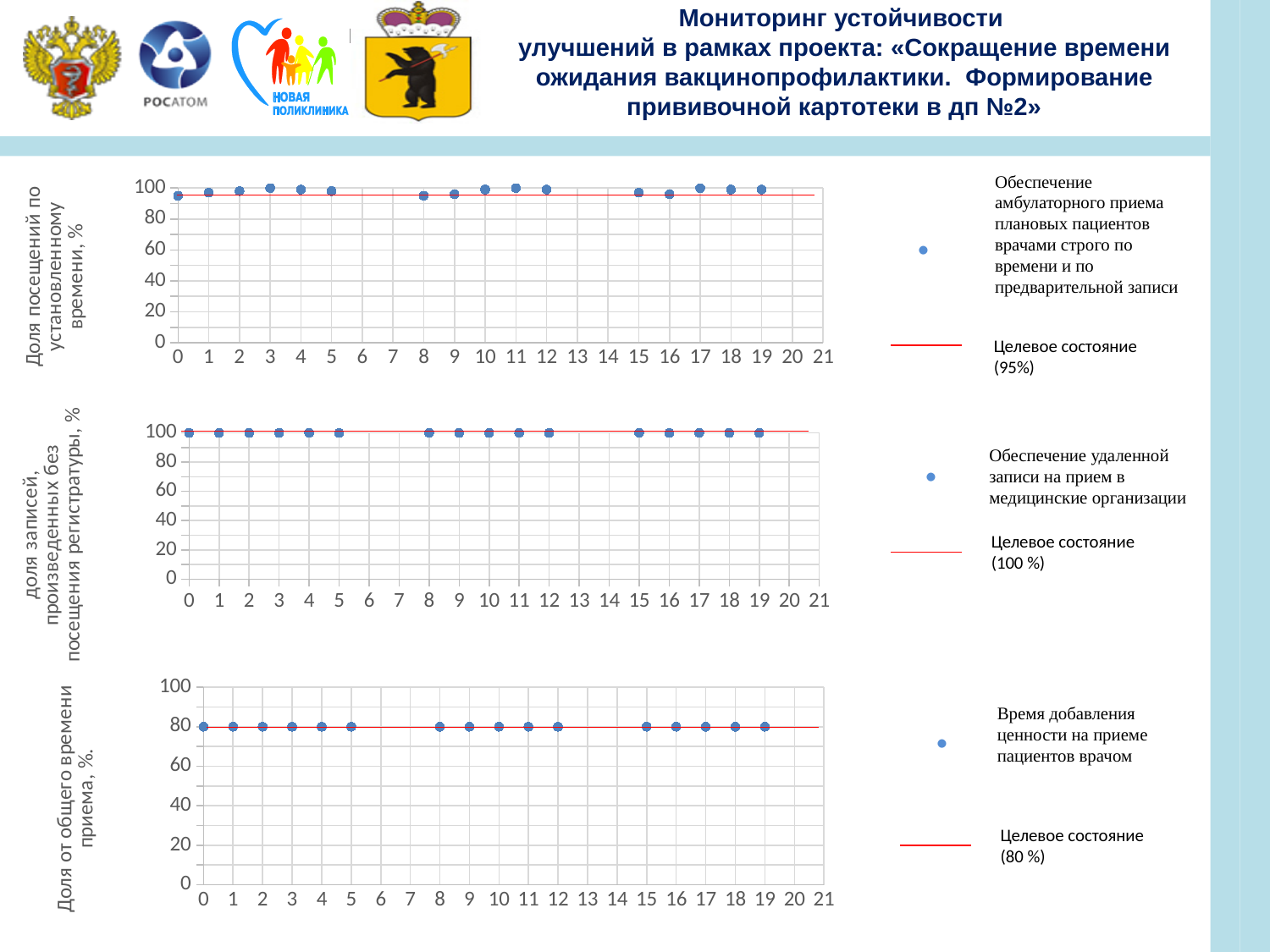
In the middle chart, what target value is given in the legend for 'Целевое состояние'? 100 % In the bottom chart, is the value at x = 5 greater or less than 60? greater How many series does the legend of the top chart list? 2 In the bottom chart, what target value is given in the legend for 'Целевое состояние'? 80 % How many data points are plotted in the middle chart? 16 What kind of chart is the top chart on the slide? scatter chart In the middle chart, is the value at x = 10 greater or less than 80? greater In the top chart, what target value is given in the legend for 'Целевое состояние'? 95% In the bottom chart, do the plotted values rise, fall, or stay flat along the x axis? stay flat In the top chart, is the value at x = 8 greater or less than 80? greater How many data points are plotted in the bottom chart? 16 What is the highest tick shown on the x axis of the top chart? 21